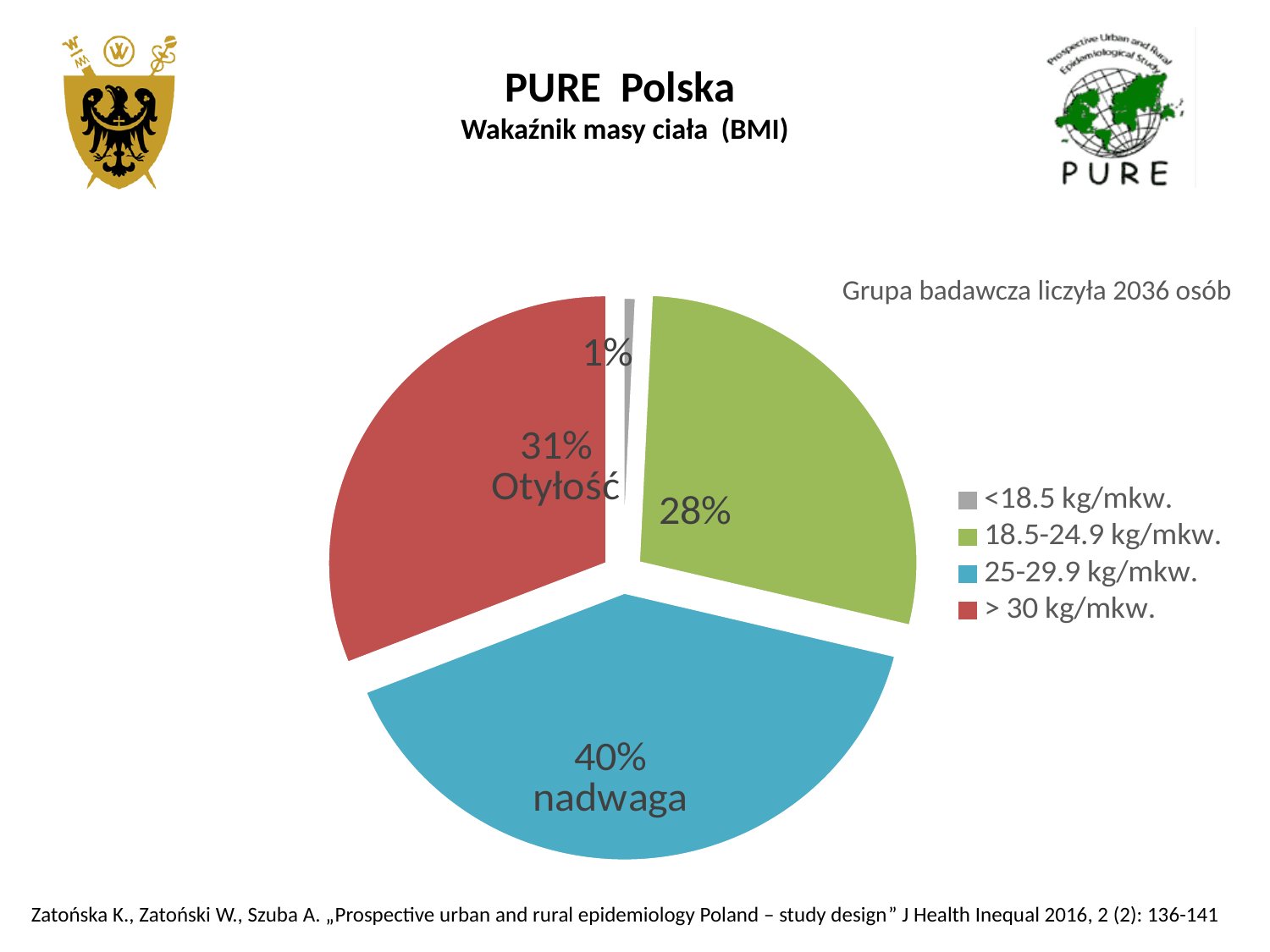
What share of the pie does the <18.5 kg/mkw. category have? 1% Which slice is larger: > 30 kg/mkw. or 18.5-24.9 kg/mkw.? > 30 kg/mkw. What share of the pie does the > 30 kg/mkw. category have? 31% Which BMI category has the smallest slice of the pie? <18.5 kg/mkw. What type of chart is shown on the slide? pie chart What label is written inside the red slice of the pie chart besides its percentage? Otyłość What share of the pie does the 18.5-24.9 kg/mkw. category have? 28% Which BMI category has the largest slice of the pie? 25-29.9 kg/mkw. What is the difference in percentage points between the 25-29.9 kg/mkw. slice and the > 30 kg/mkw. slice? 9 What colour is the slice for the 25-29.9 kg/mkw. category? blue How many categories does the legend of the pie chart list? 4